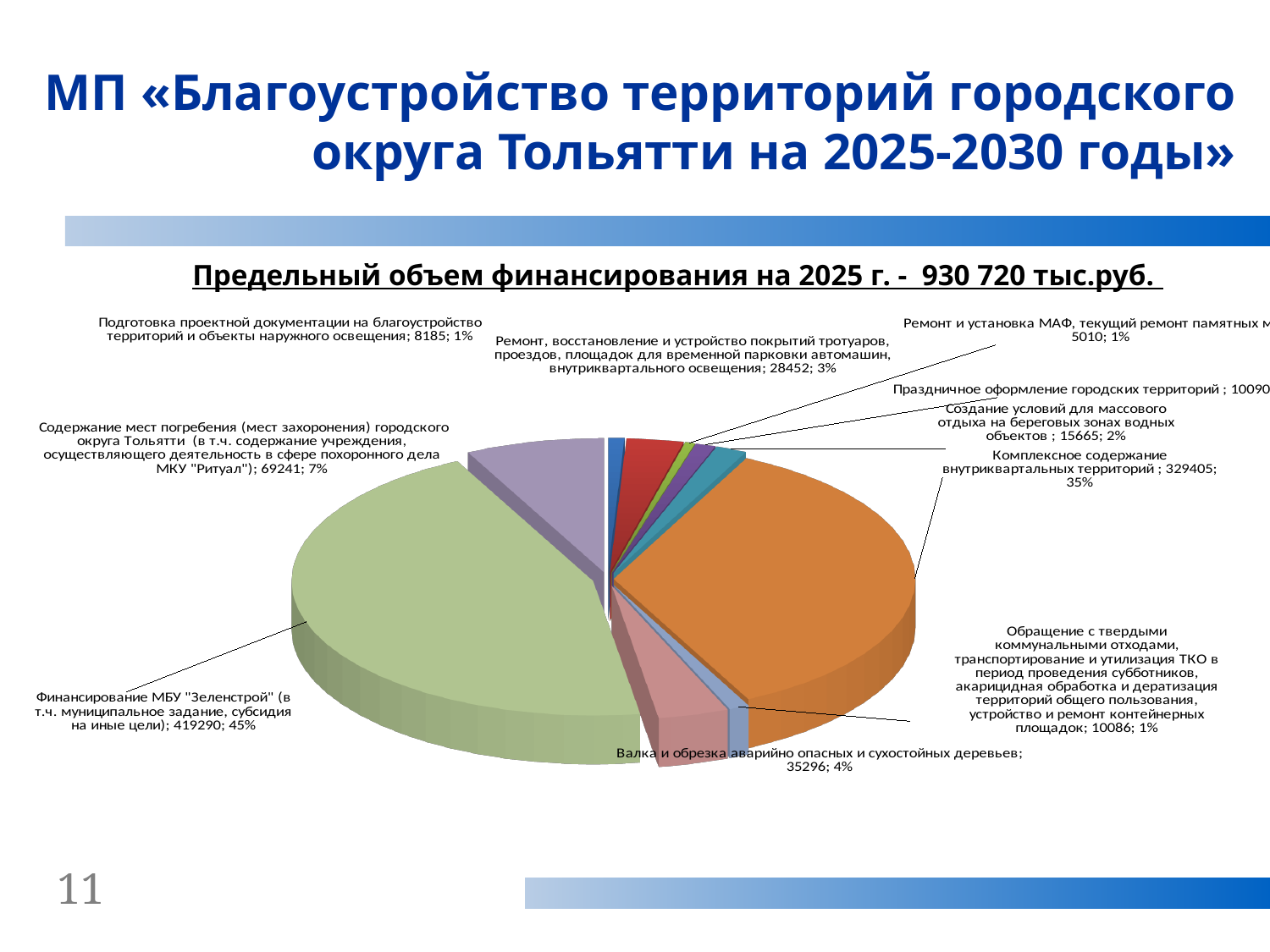
Which is larger: the value for Валка и обрезка аварийно опасных и сухостойных деревьев or the value for Ремонт, восстановление и устройство покрытий тротуаров? Валка и обрезка аварийно опасных и сухостойных деревьев What is the value for Содержание мест погребения (МКУ "Ритуал")? 69241 Which category has the largest slice of the pie? Финансирование МБУ "Зеленстрой" Which category has the smallest slice of the pie? Ремонт и установка МАФ What share of the pie does Комплексное содержание внутриквартальных территорий represent? 35% How many slices does the pie chart have? 10 What is the difference between the values for Финансирование МБУ "Зеленстрой" and Комплексное содержание внутриквартальных территорий? 89885 What is the value for Финансирование МБУ "Зеленстрой"? 419290 What is the value for Валка и обрезка аварийно опасных и сухостойных деревьев? 35296 What is the value for Комплексное содержание внутриквартальных территорий? 329405 What kind of chart is shown on the slide? pie chart What total funding amount for 2025 is stated in the chart title? 930 720 тыс.руб.